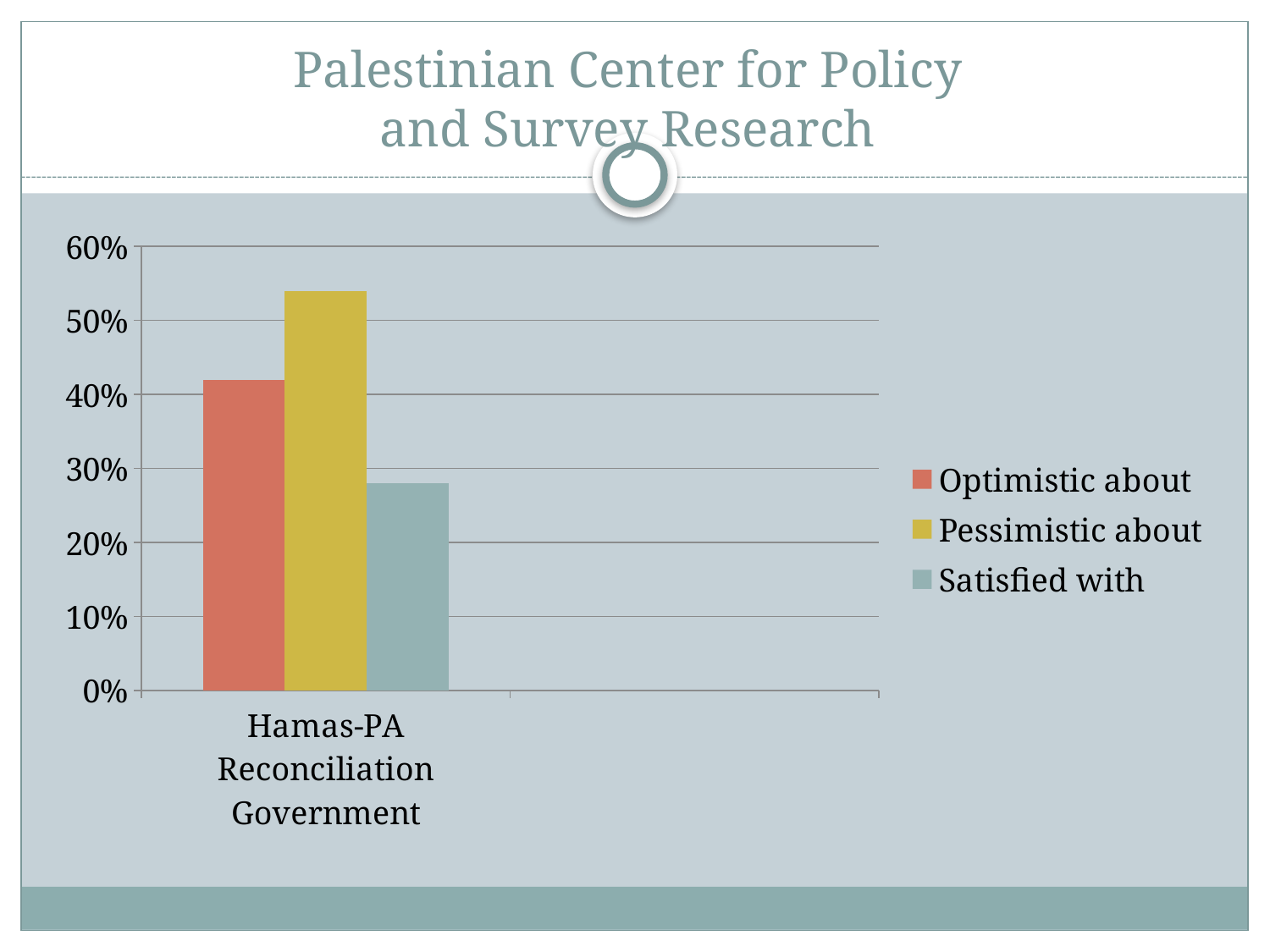
Which series has the lowest value for Hamas-PA Reconciliation Government? Satisfied with Is the value for Satisfied with greater or less than 30%? less Is the value for Satisfied with greater or less than 20%? greater How many categories are shown on the x axis? 1 Is the value for Pessimistic about greater or less than 50%? greater Which is larger, the value for Optimistic about or the value for Satisfied with? Optimistic about What is the category label shown on the x axis? Hamas-PA Reconciliation Government Which series has the highest value for Hamas-PA Reconciliation Government? Pessimistic about Which is larger, the value for Pessimistic about or the value for Optimistic about? Pessimistic about What kind of chart is shown on the slide? Bar chart How many series does the legend list? 3